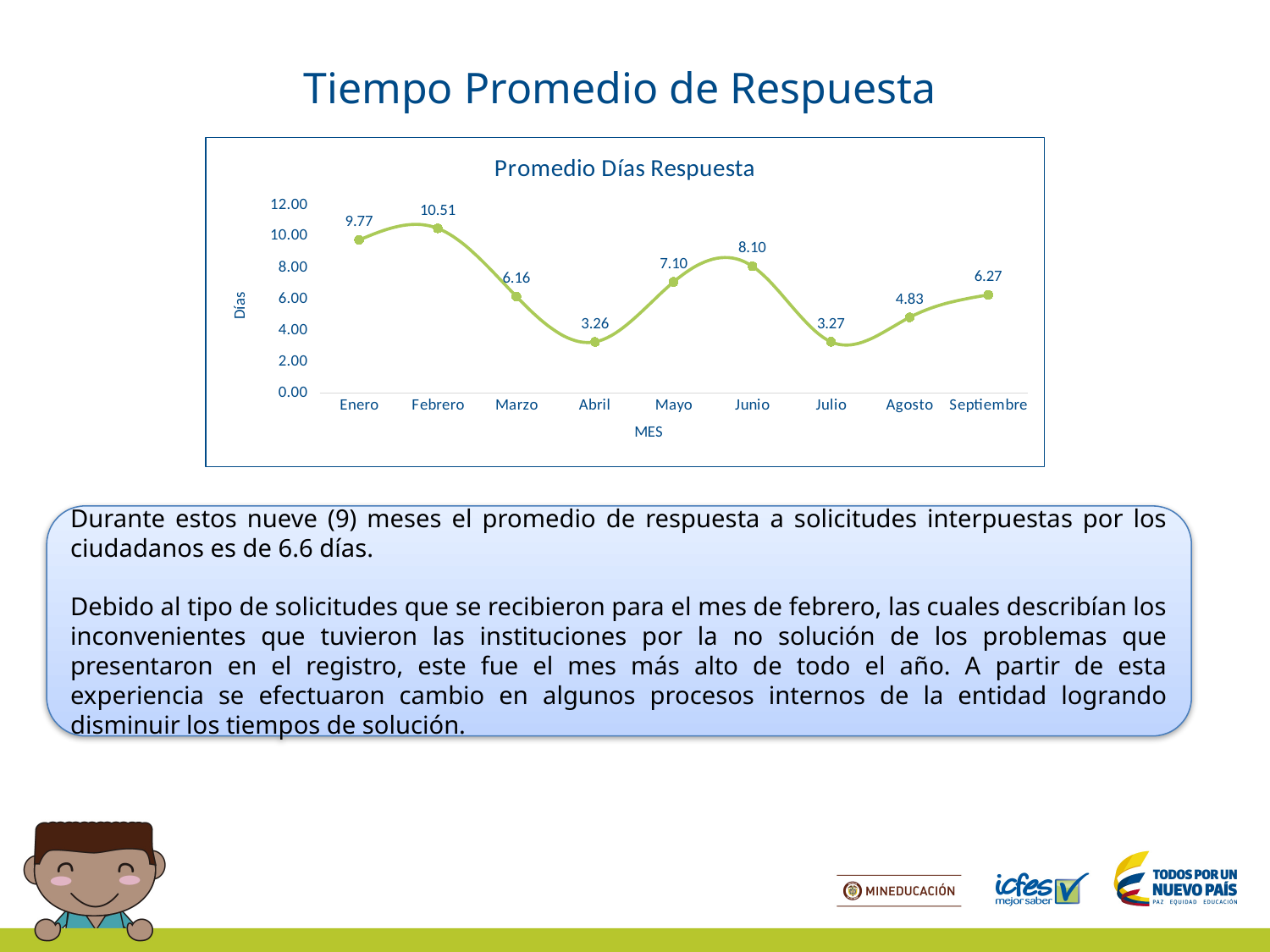
What is the value for Abril in the Promedio Días Respuesta chart? 3.26 What is the value for Septiembre in the Promedio Días Respuesta chart? 6.27 Is the value for Enero in the Promedio Días Respuesta chart greater or less than 8.00? greater What kind of chart is the Promedio Días Respuesta chart? line chart Which is larger in the Promedio Días Respuesta chart, the value for Mayo or the value for Junio? Junio What is the label on the vertical axis of the Promedio Días Respuesta chart? Días What is the difference between the values for Junio and Julio in the Promedio Días Respuesta chart? 4.83 Do the values in the Promedio Días Respuesta chart rise or fall from Febrero to Abril? fall What is the difference between the values for Febrero and Enero in the Promedio Días Respuesta chart? 0.74 How many months are plotted in the Promedio Días Respuesta chart? 9 Which month has the highest value in the Promedio Días Respuesta chart? Febrero What is the value for Febrero in the Promedio Días Respuesta chart? 10.51